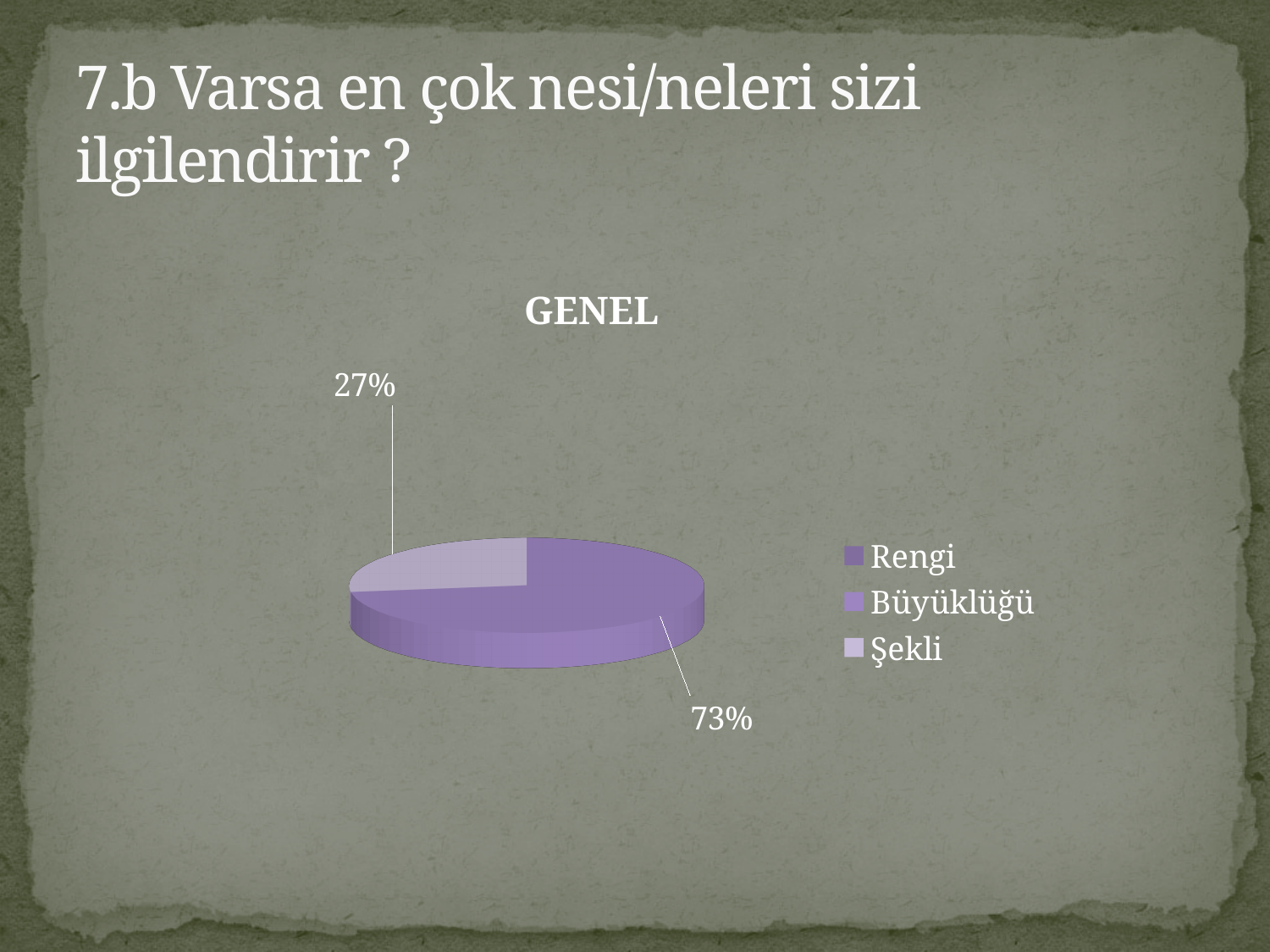
What share of the pie does Şekli take? 27% What kind of chart is shown on the slide? pie chart How many slices with data labels are visible in the pie? 2 What is the title of the chart? GENEL Which legend entry is shown in the lightest shade of purple? Şekli How many entries does the chart's legend list? 3 Which category has the largest slice of the pie? Büyüklüğü